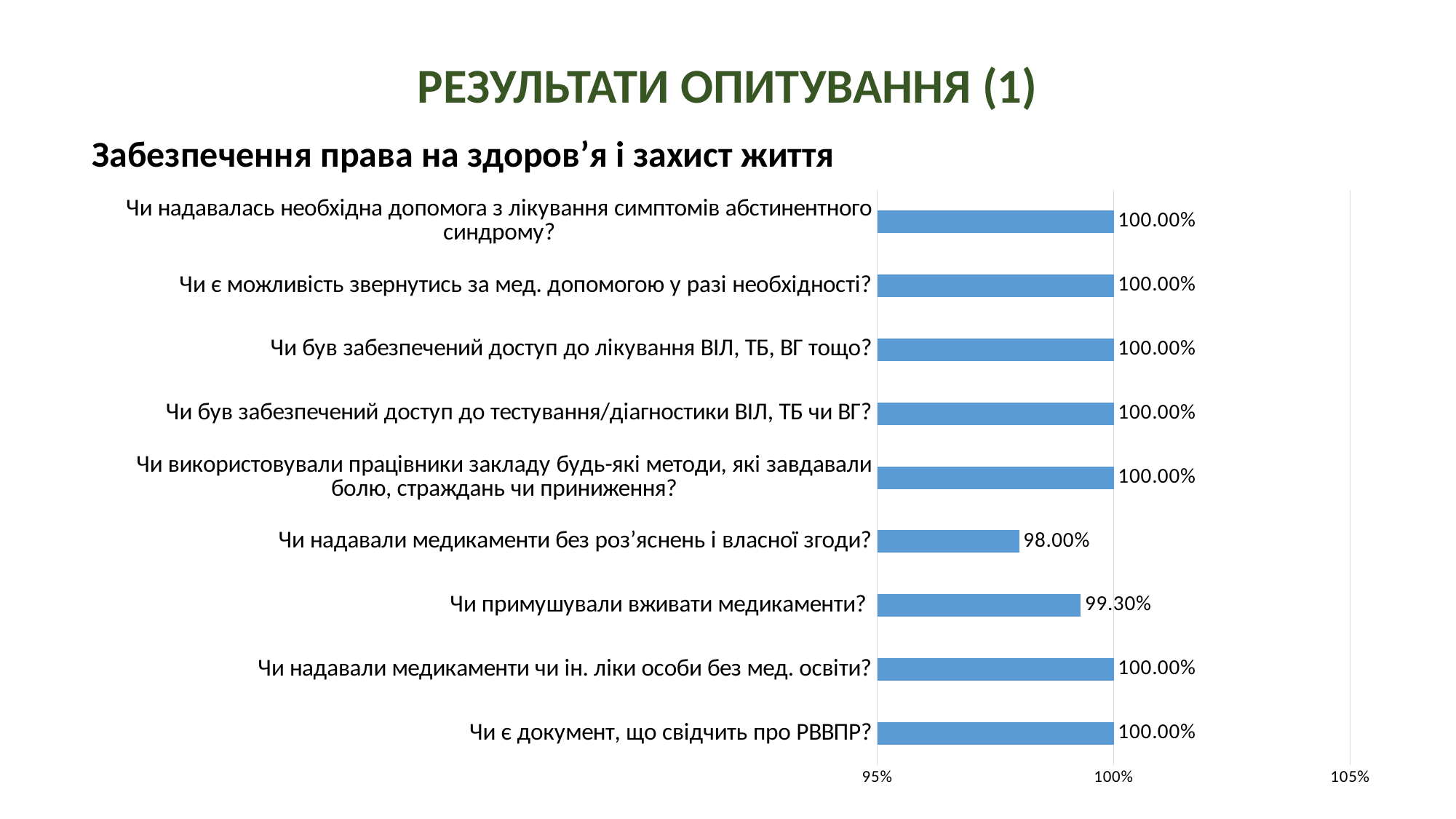
What type of chart is shown on the slide? bar chart What is the value for "Чи був забезпечений доступ до лікування ВІЛ, ТБ, ВГ тощо?"? 100.00% What is the difference between the value for "Чи примушували вживати медикаменти?" and the value for "Чи надавали медикаменти без роз’яснень і власної згоди?"? 1.30% Is the value for "Чи надавали медикаменти без роз’яснень і власної згоди?" greater or less than 100%? less How many categories (questions) are plotted in the chart? 9 What is the value for "Чи є документ, що свідчить про РВВПР?"? 100.00% What is the value for "Чи примушували вживати медикаменти?"? 99.30% What is the heading shown above the chart? Забезпечення права на здоров’я і захист життя Which category has the lowest value in the chart? Чи надавали медикаменти без роз’яснень і власної згоди? How many categories in the chart have a value of 100.00%? 7 What is the value for "Чи надавали медикаменти без роз’яснень і власної згоди?"? 98.00% Which is larger: the value for "Чи примушували вживати медикаменти?" or the value for "Чи надавали медикаменти без роз’яснень і власної згоди?"? Чи примушували вживати медикаменти?